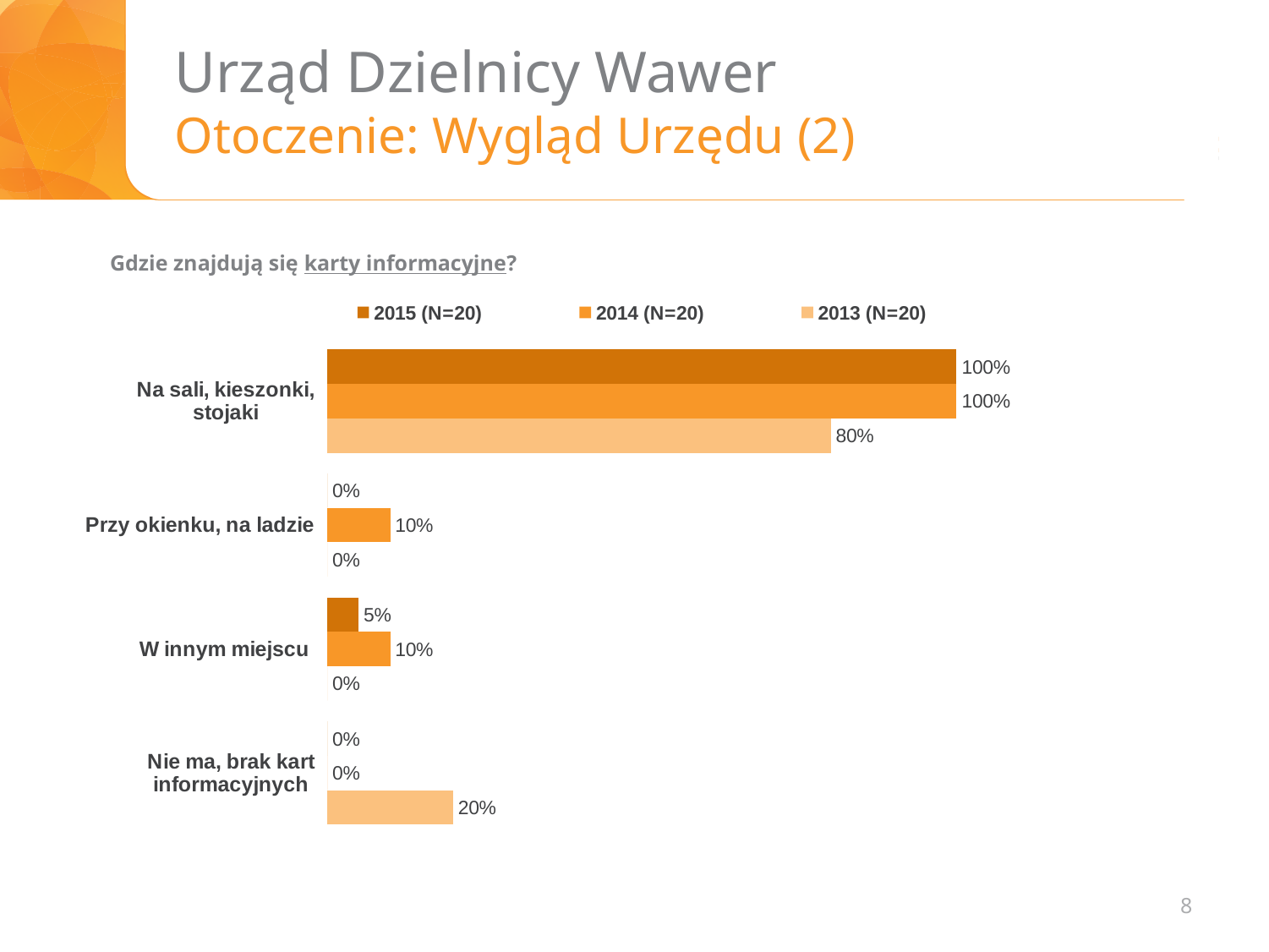
What question does the chart answer, according to the text above it? Gdzie znajdują się karty informacyjne? What is the value for 'Na sali, kieszonki, stojaki' in the 2013 (N=20) series? 80% What is the difference between the 2015 (N=20) and 2013 (N=20) values for 'Na sali, kieszonki, stojaki'? 20% What is the value for 'W innym miejscu' in the 2015 (N=20) series? 5% What is the difference between the 2014 (N=20) and 2013 (N=20) values for 'Nie ma, brak kart informacyjnych'? 20% Which is larger for 'W innym miejscu': the 2015 (N=20) value or the 2014 (N=20) value? 2014 (N=20) Which category has the highest value in the 2015 (N=20) series? Na sali, kieszonki, stojaki What is the value for 'Nie ma, brak kart informacyjnych' in the 2013 (N=20) series? 20% How many series does the legend list? 3 What is the value for 'Przy okienku, na ladzie' in the 2014 (N=20) series? 10% What kind of chart is shown on the slide? Bar chart How many categories are shown on the chart? 4